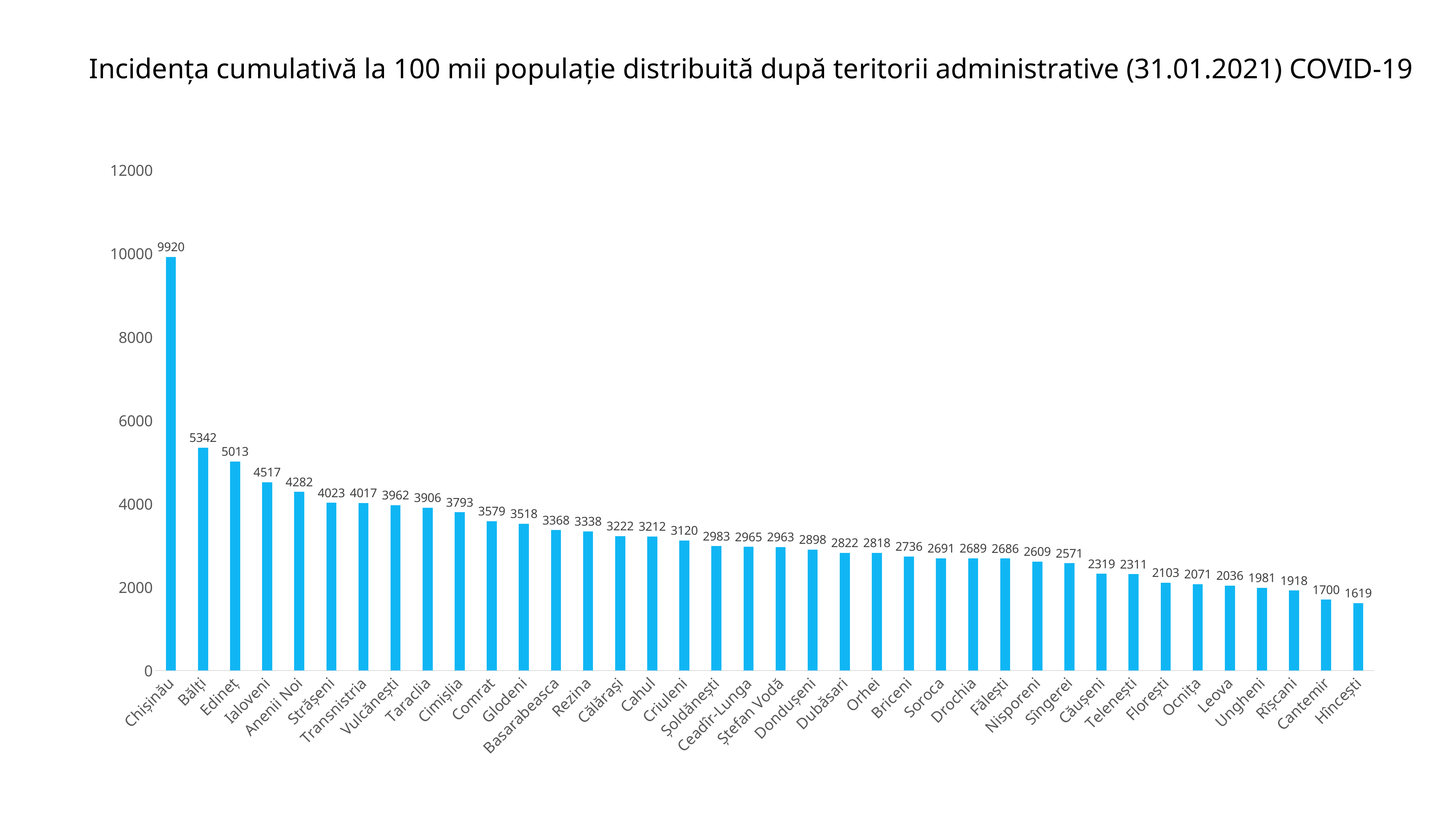
Which territory has the highest value? Chișinău How many territories are shown on the chart? 38 Is the value for Strășeni greater or less than 4000? greater What is the value for Chișinău? 9920 Which territory has the lowest value? Hîncești Which has a larger value, Cahul or Căușeni? Cahul What is the difference between the values for Chișinău and Bălți? 4578 What is the value for Cantemir? 1700 What is the value for Comrat? 3579 What kind of chart is this? bar chart What is the value for Orhei? 2818 What is the difference between the values for Edineț and Ialoveni? 496